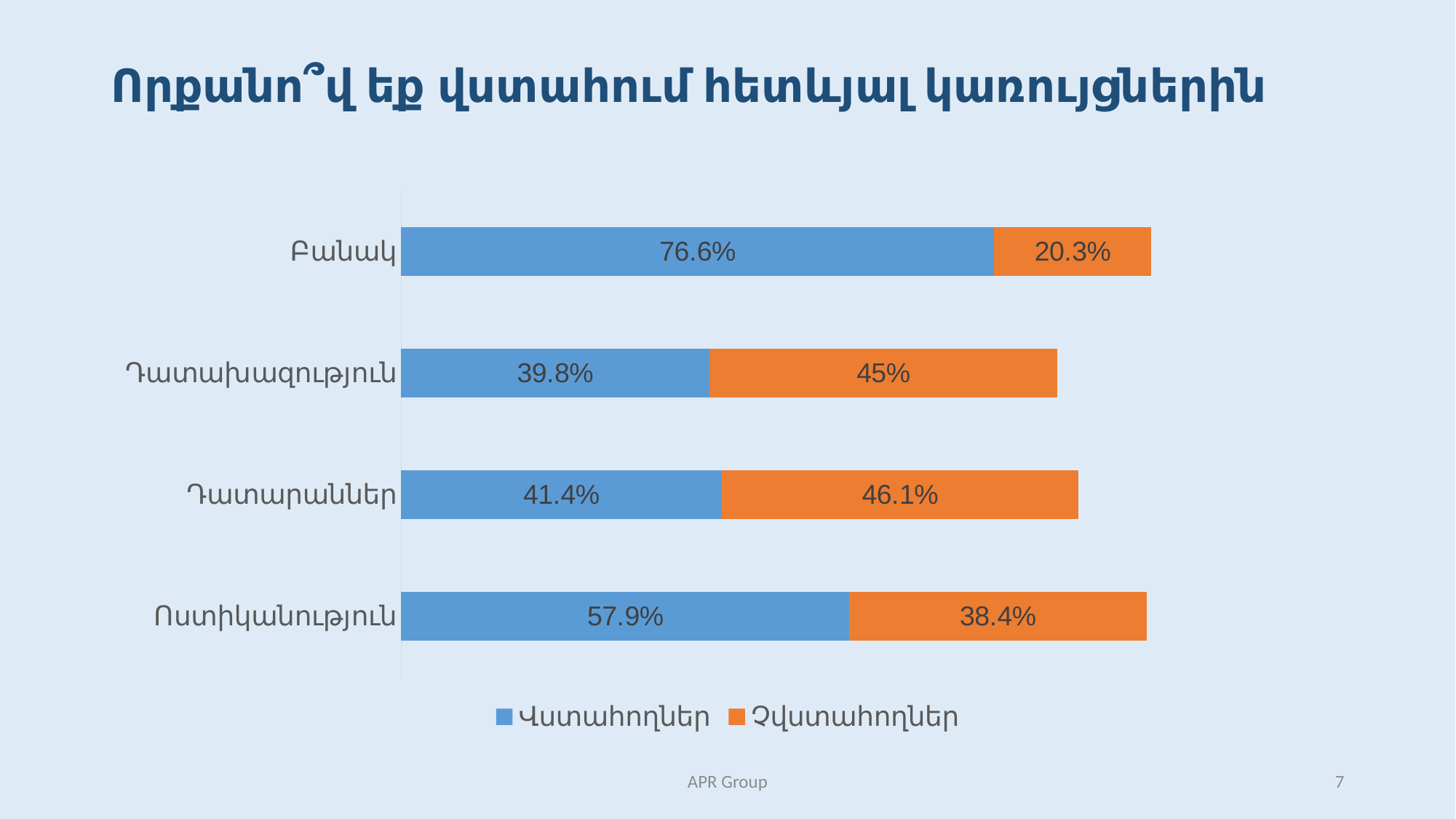
What is the Չվստահողներ value for Դատարաններ? 46.1% What is the difference between the Վստահողներ and Չվստահողներ values for Բանակ? 56.3% What is the total of the stacked bar for Ոստիկանություն? 96.3% What is the Չվստահողներ value for Դատախազություն? 45% Which category has the highest Վստահողներ value? Բանակ Which category has the lowest Չվստահողներ value? Բանակ How many categories are shown in the chart? 4 What is the Վստահողներ value for Բանակ? 76.6% What type of chart is shown on the slide? Stacked bar chart How many series does the legend list? 2 Which is larger for Դատարաններ: the Վստահողներ value or the Չվստահողներ value? Չվստահողներ What is the Վստահողներ value for Ոստիկանություն? 57.9%